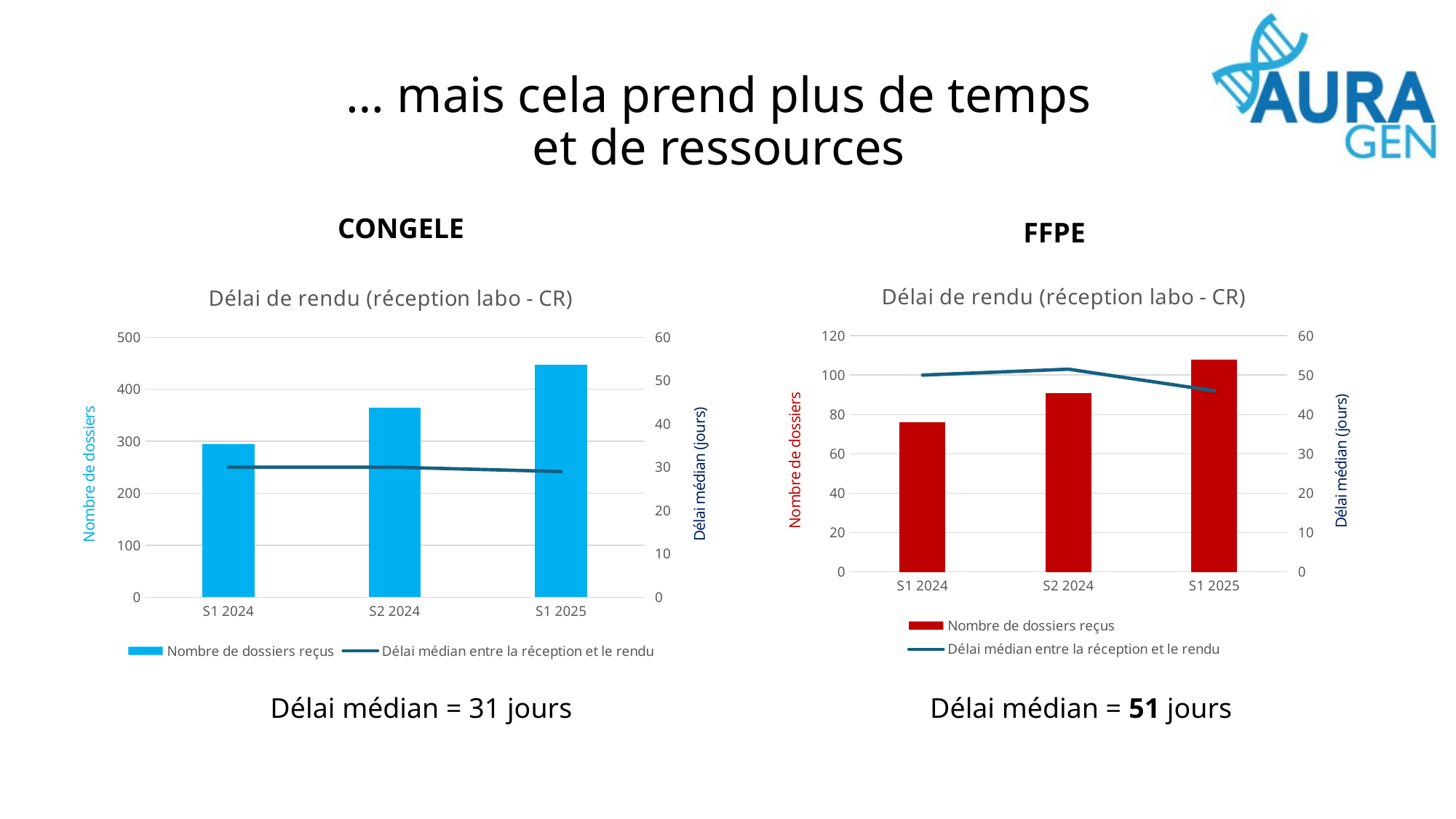
In the FFPE chart, which period has the lowest number of dossiers reçus? S1 2024 How many periods are shown on the x axis of the FFPE chart? 3 In the CONGELE chart, which period has the highest number of dossiers reçus? S1 2025 In the CONGELE chart, which period has the lowest number of dossiers reçus? S1 2024 In the CONGELE chart, does the number of dossiers reçus rise or fall from S1 2024 to S1 2025? rise In the FFPE chart, is the number of dossiers reçus for S1 2024 greater or less than 80? less What is the title of the FFPE chart? Délai de rendu (réception labo - CR) How many series does the legend of the CONGELE chart list? 2 In the FFPE chart, is the number of dossiers reçus for S1 2025 greater or less than 100? greater In the CONGELE chart, is the number of dossiers reçus for S1 2025 greater or less than 400? greater In the FFPE chart, which is larger, the number of dossiers reçus for S2 2024 or for S1 2024? S2 2024 In the FFPE chart, which period has the highest number of dossiers reçus? S1 2025